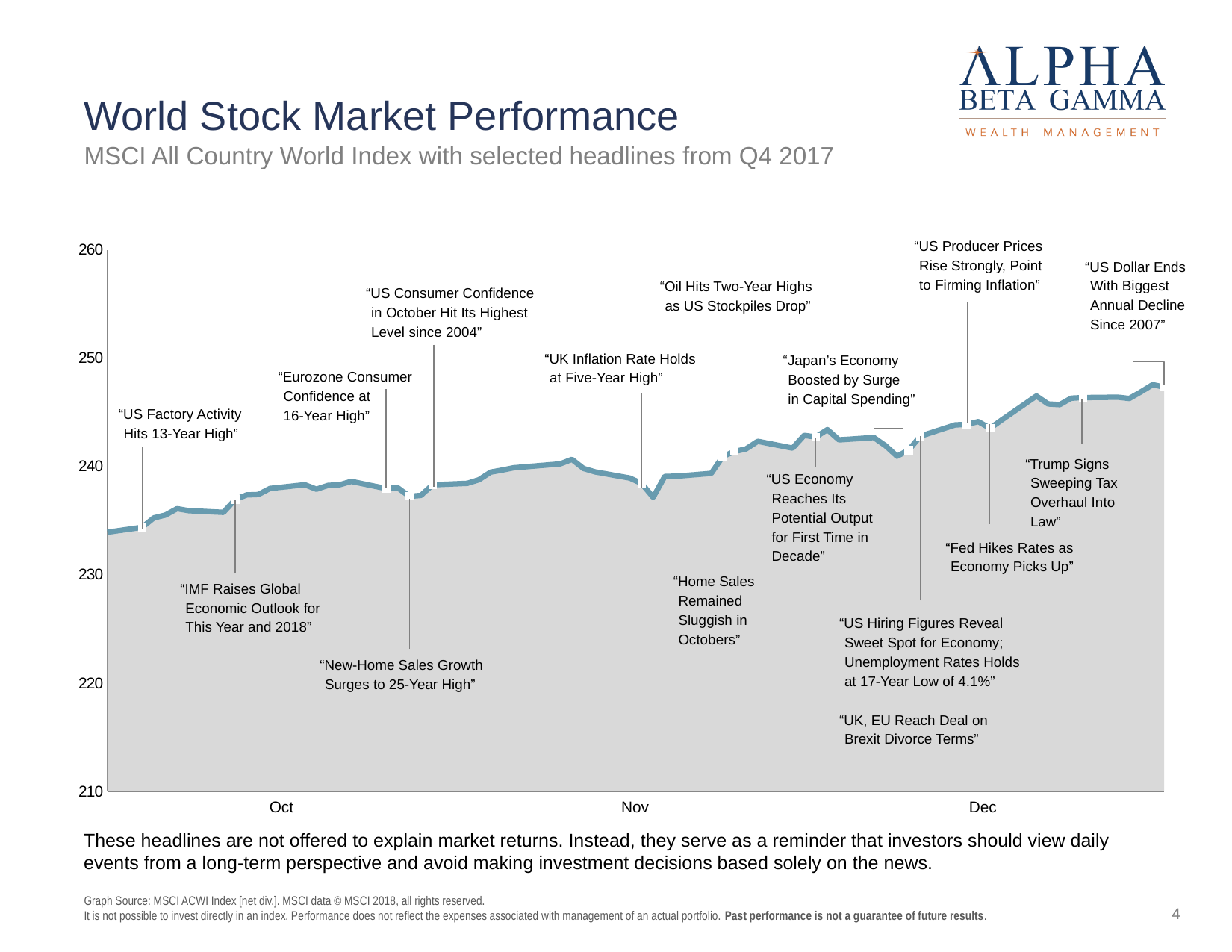
Does the index value generally rise or fall from October to December? rise Is the index value at the point marked "Trump Signs Sweeping Tax Overhaul Into Law" greater or less than 240? greater Is the index value at the point marked "US Factory Activity Hits 13-Year High" greater or less than 240? less Is the index value at the start of October greater or less than 240? less What kind of chart is shown on the slide? area chart What is the lowest value shown on the y axis? 210 What is the title of the chart on the slide? World Stock Market Performance How many month labels are shown on the x axis? 3